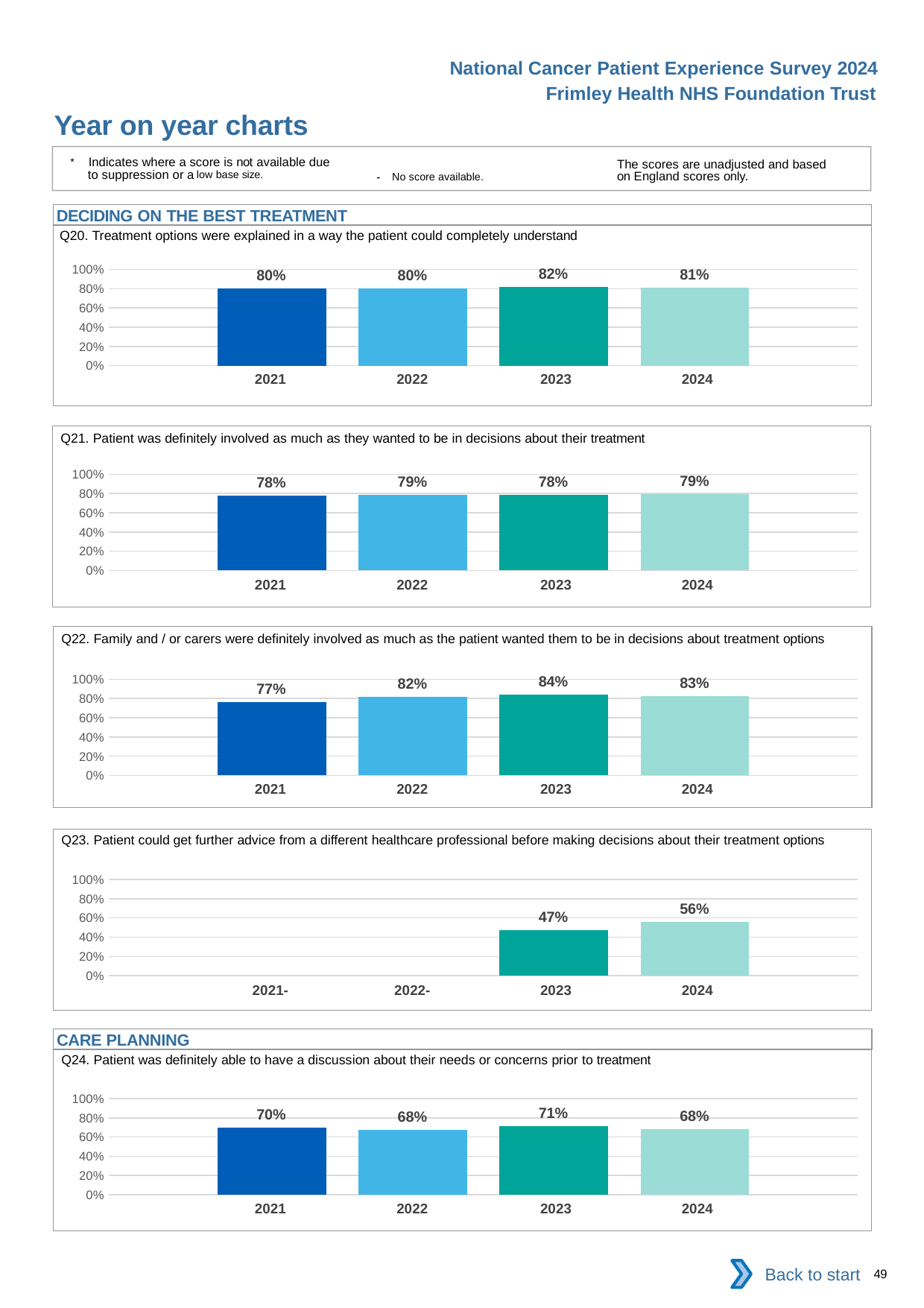
In the Q23 chart, how many years have a bar plotted? 2 In the Q20 chart, which year has the highest value? 2023 In the Q22 chart, which year has the lowest value? 2021 In the Q21 chart, what is the value for 2024? 79% In the Q24 chart, is the value for 2022 greater or less than 80%? less In the Q24 chart, which year has the highest value? 2023 In the Q24 chart, what is the value for 2021? 70% In the Q22 chart, what is the difference between the 2023 value and the 2021 value? 7% In the Q23 chart, what is the value for 2024? 56% What kind of chart is the Q21 chart? bar chart In the Q20 chart, what is the value for 2023? 82% In the Q23 chart, which is larger, the value for 2023 or the value for 2024? 2024